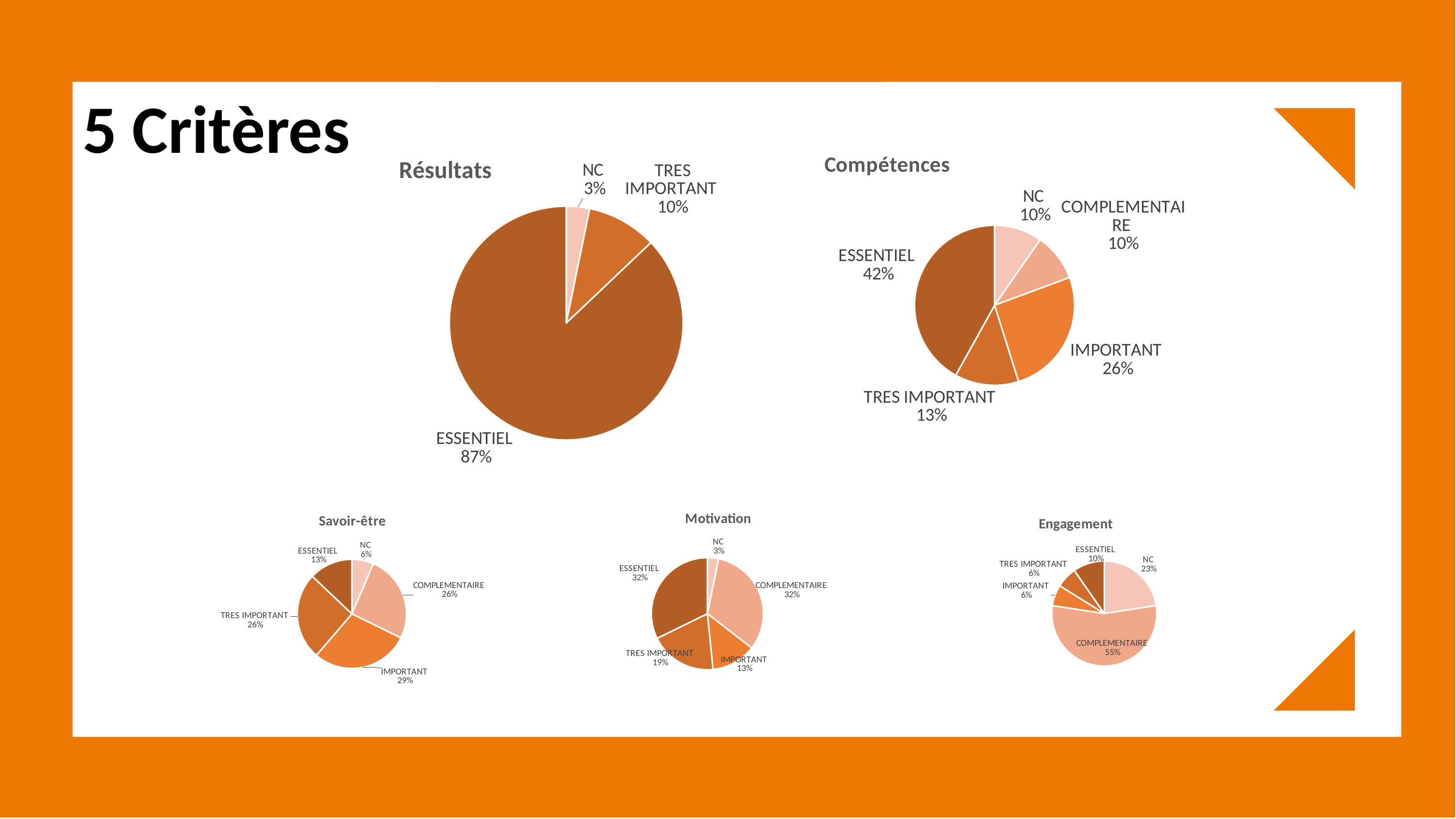
In the 'Motivation' chart, which is larger, ESSENTIEL or TRES IMPORTANT? ESSENTIEL How many slices does the 'Engagement' chart have? 5 In the 'Compétences' chart, what is the value for IMPORTANT? 26% What type of chart is the 'Résultats' chart? Pie chart In the 'Compétences' chart, which category has the largest share? ESSENTIEL In the 'Résultats' chart, what share does ESSENTIEL have? 87% In the 'Compétences' chart, what is the difference between ESSENTIEL and TRES IMPORTANT? 29% In the 'Savoir-être' chart, what is the value for IMPORTANT? 29% In the 'Savoir-être' chart, which category has the smallest share? NC In the 'Engagement' chart, which category has the largest share? COMPLEMENTAIRE In the 'Résultats' chart, what is the value for TRES IMPORTANT? 10% In the 'Motivation' chart, what is the value for TRES IMPORTANT? 19%